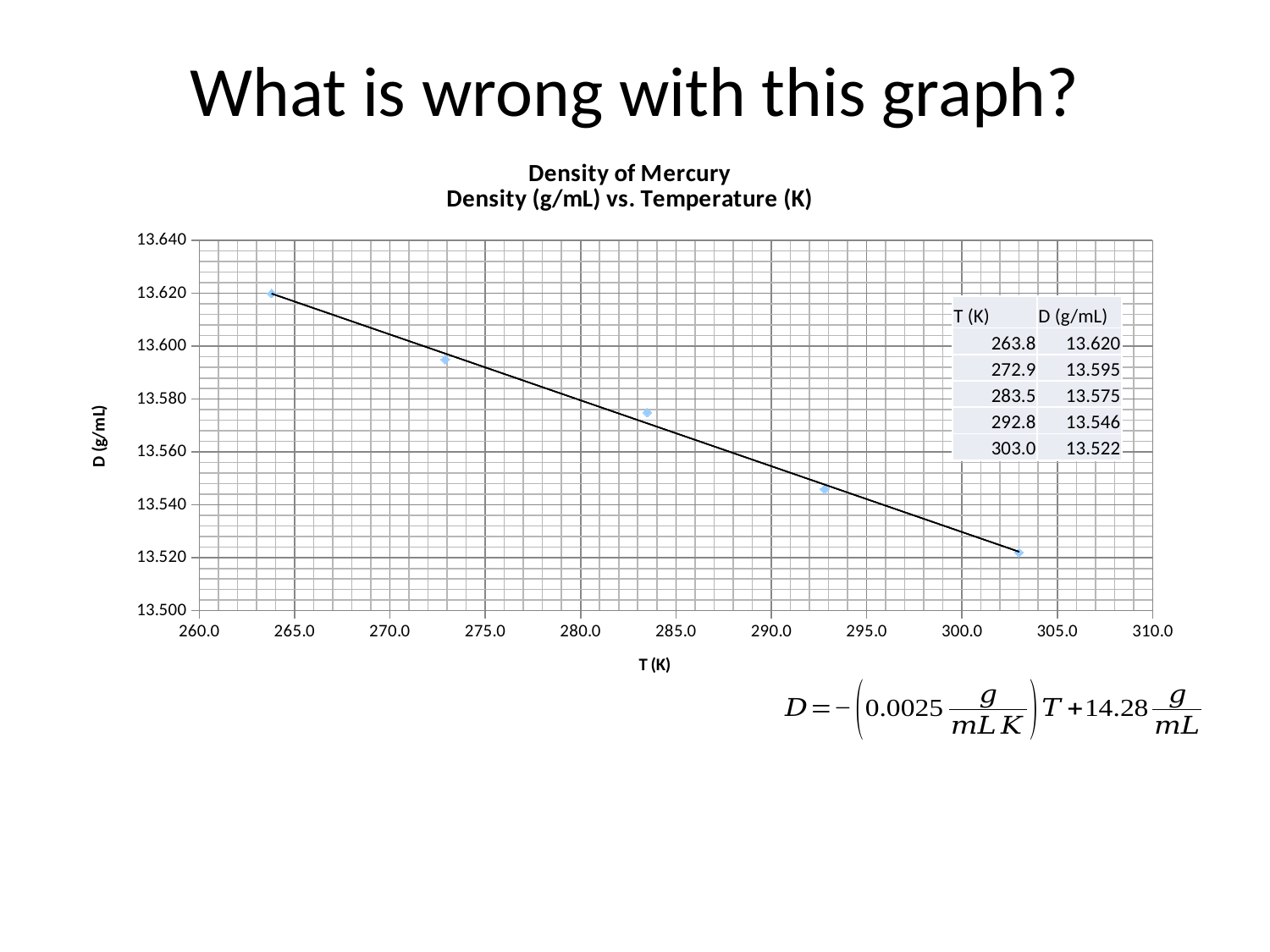
At which temperature is the density lowest? 303.0 What is the density D (g/mL) at T = 283.5 K? 13.575 What is the label of the y axis? D (g/mL) What is the title of the chart? Density of Mercury Density (g/mL) vs. Temperature (K) Which has the larger density, T = 272.9 K or T = 292.8 K? 272.9 At which temperature is the density highest? 263.8 How many data points are plotted on the chart? 5 What is the density D (g/mL) at T = 263.8 K? 13.620 What is the density D (g/mL) at T = 303.0 K? 13.522 Do the density values rise or fall as temperature increases along the x axis? fall What is the difference in density between T = 263.8 K and T = 303.0 K? 0.098 What kind of chart is shown on the slide? scatter chart